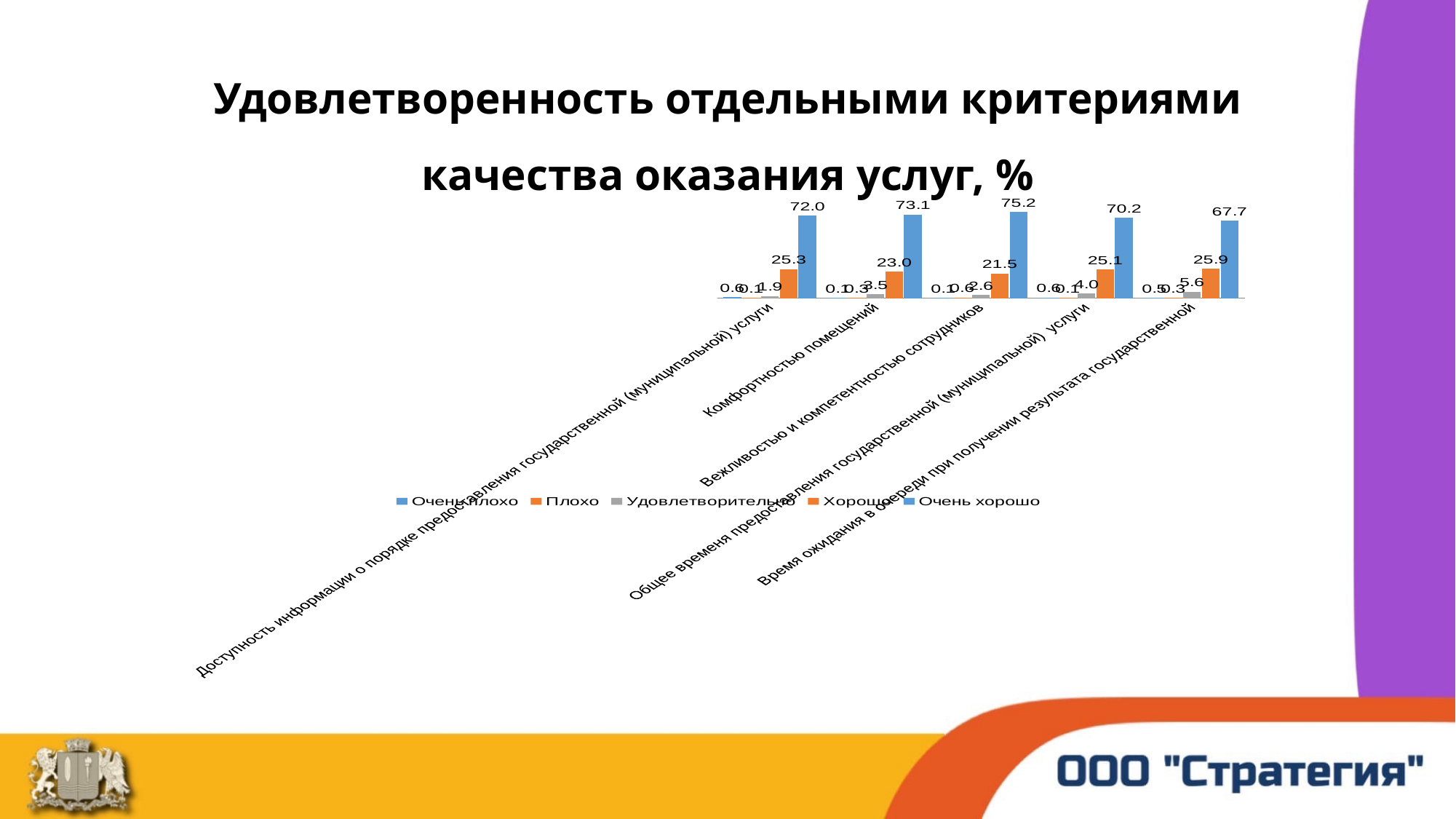
How many categories are shown on the x axis? 5 What is the difference between the "Очень хорошо" values for "Вежливостью и компетентностью сотрудников" and "Время ожидания в очереди при получении результата государственной"? 7.5 What type of chart is shown on the slide? Bar chart What is the title of the chart on the slide? Удовлетворенность отдельными критериями качества оказания услуг, % What is the value of "Хорошо" for "Вежливостью и компетентностью сотрудников"? 21.5 Which category has the lowest "Очень хорошо" value? Время ожидания в очереди при получении результата государственной What is the value of "Очень хорошо" for "Комфортностью помещений"? 73.1 What is the value of "Удовлетворительно" for "Общее время предоставления государственной (муниципальной) услуги"? 4.0 Which category has the highest "Удовлетворительно" value? Время ожидания в очереди при получении результата государственной Which is larger: the "Хорошо" value for "Доступность информации о порядке предоставления государственной (муниципальной) услуги" or for "Комфортностью помещений"? Доступность информации о порядке предоставления государственной (муниципальной) услуги How many series does the legend list? 5 Which category has the highest "Очень хорошо" value? Вежливостью и компетентностью сотрудников